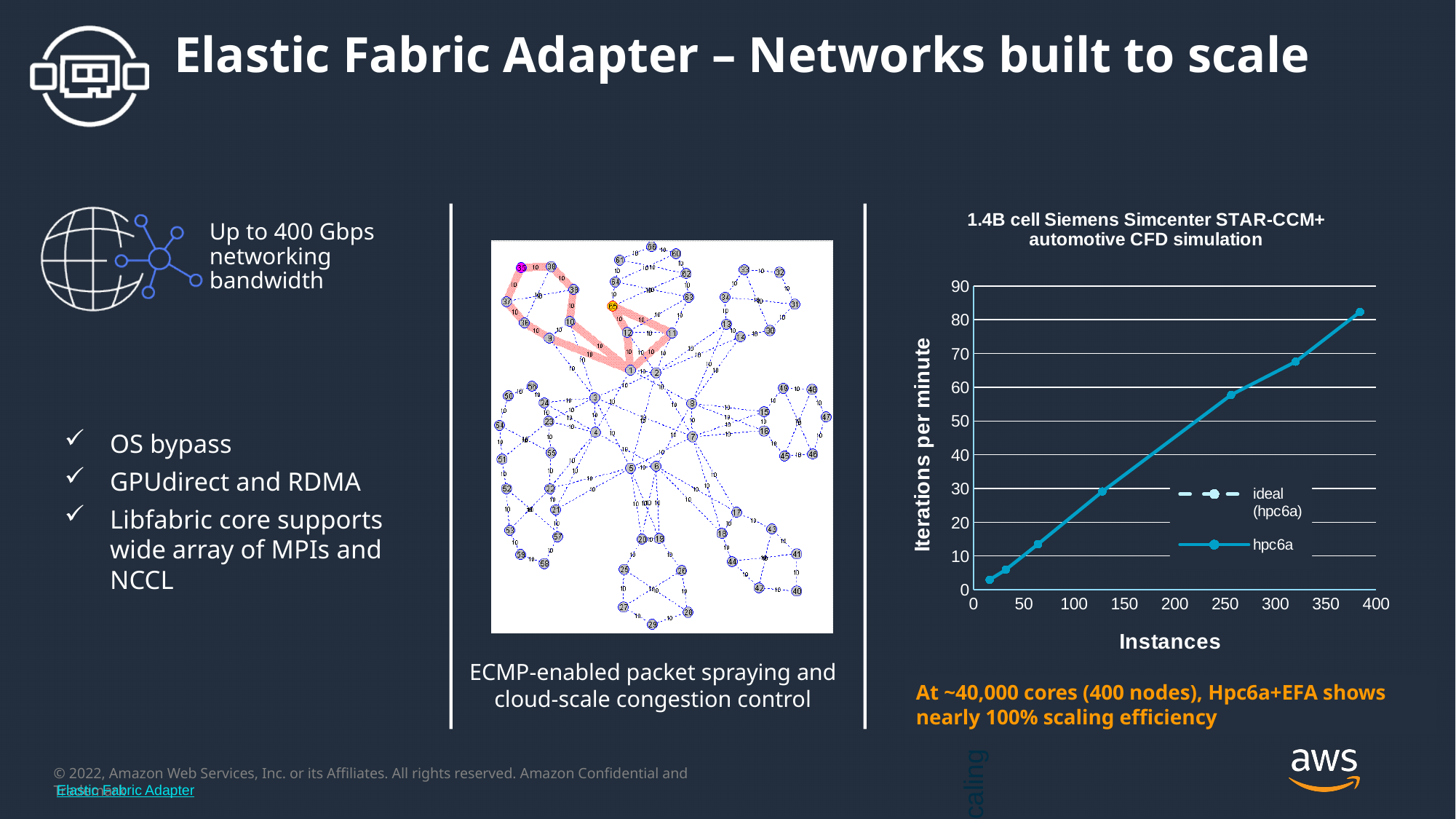
What is the title of the chart on the right side of the slide? 1.4B cell Siemens Simcenter STAR-CCM+ automotive CFD simulation What is the label of the x axis of the chart? Instances Is the hpc6a value at about 192 instances greater or less than 50 iterations per minute? less How many data points are plotted on the hpc6a line? 8 Do the iterations per minute rise or fall as the number of instances increases? rise How many series does the legend of the chart list? 2 What kind of chart is shown on the right side of the slide? line chart Is the hpc6a value at about 256 instances greater or less than 50 iterations per minute? greater What is the label of the y axis of the chart? Iterations per minute Is the hpc6a value at about 64 instances greater or less than 20 iterations per minute? less What are the two entries in the chart's legend? ideal (hpc6a) and hpc6a What is the highest value shown on the x axis of the chart? 400